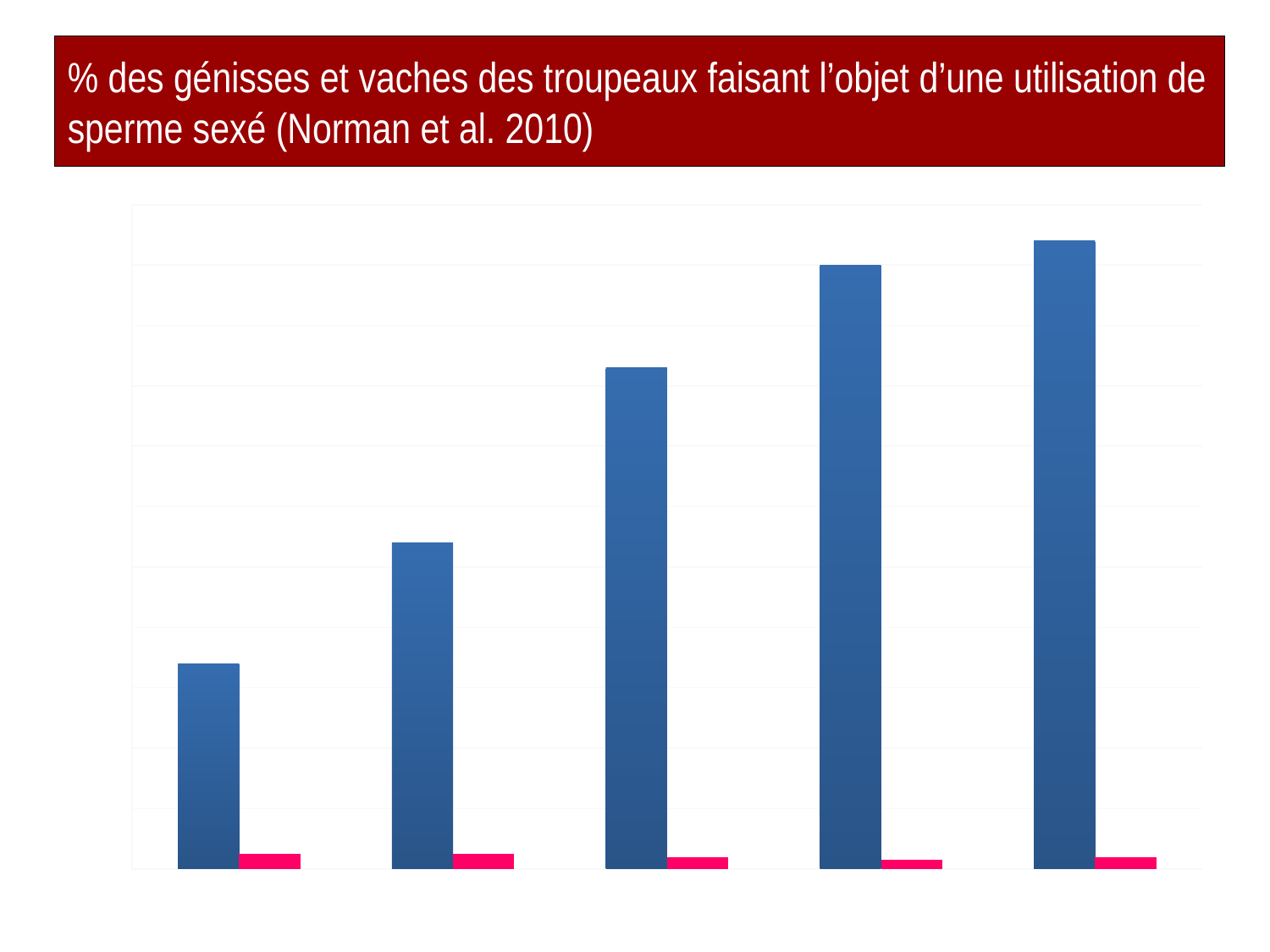
What is the title shown above the chart? % des génisses et vaches des troupeaux faisant l'objet d'une utilisation de sperme sexé (Norman et al. 2010) What kind of chart is shown on the slide? bar chart Which group of bars, counting from the left, has the tallest blue bar? the fifth (rightmost) How many groups of bars are plotted along the x axis? 5 Which colour of bar is consistently the shorter one in every group? pink Is the blue bar in the third group from the left taller or shorter than the blue bar in the fourth group? shorter How many differently coloured bar series are plotted in the chart? 2 In the leftmost group, which bar is taller, the blue bar or the pink bar? the blue bar Which group of bars, counting from the left, has the shortest blue bar? the first (leftmost) Do the blue bars rise or fall from left to right along the x axis? rise